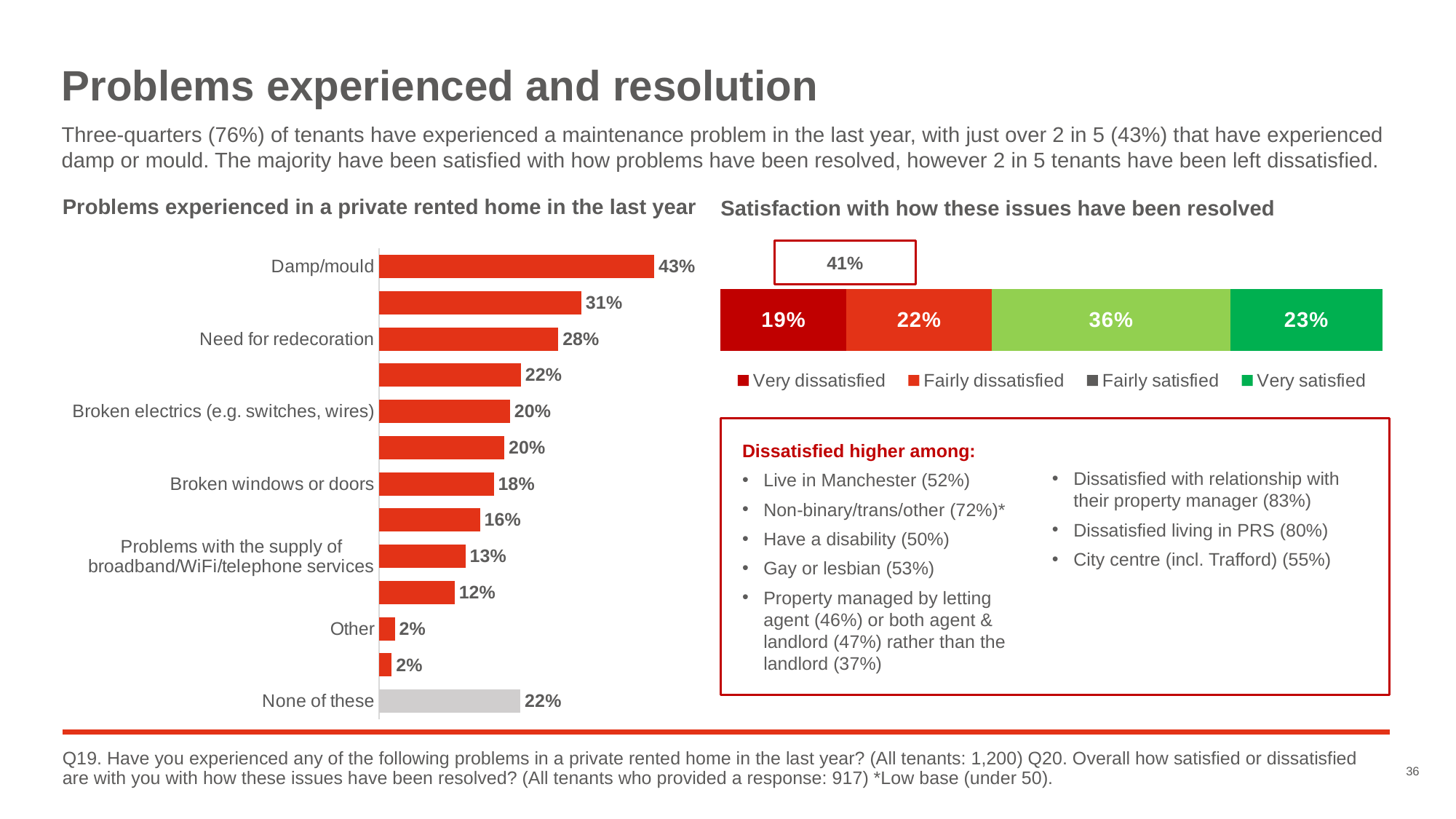
In the chart 'Problems experienced in a private rented home in the last year', which labelled problem has the highest value? Damp/mould In the chart 'Problems experienced in a private rented home in the last year', what percentage of tenants experienced damp/mould? 43% In the chart 'Problems experienced in a private rented home in the last year', what is the difference between the values for 'Damp/mould' and 'Need for redecoration'? 15% In the chart 'Problems experienced in a private rented home in the last year', what is the value for 'Broken windows or doors'? 18% In the chart 'Problems experienced in a private rented home in the last year', what percentage of tenants selected 'None of these'? 22% In the chart 'Problems experienced in a private rented home in the last year', what is the value for 'Need for redecoration'? 28% How many series does the legend list in the chart 'Satisfaction with how these issues have been resolved'? 4 In the chart 'Satisfaction with how these issues have been resolved', what percentage of tenants were 'Very dissatisfied'? 19% In the chart 'Satisfaction with how these issues have been resolved', which category has the largest share? Fairly satisfied In the chart 'Satisfaction with how these issues have been resolved', what is the combined value of 'Very dissatisfied' and 'Fairly dissatisfied'? 41% In the chart 'Problems experienced in a private rented home in the last year', which is larger: 'Broken electrics (e.g. switches, wires)' or 'Problems with the supply of broadband/WiFi/telephone services'? Broken electrics (e.g. switches, wires) What kind of chart is 'Problems experienced in a private rented home in the last year'? Bar chart